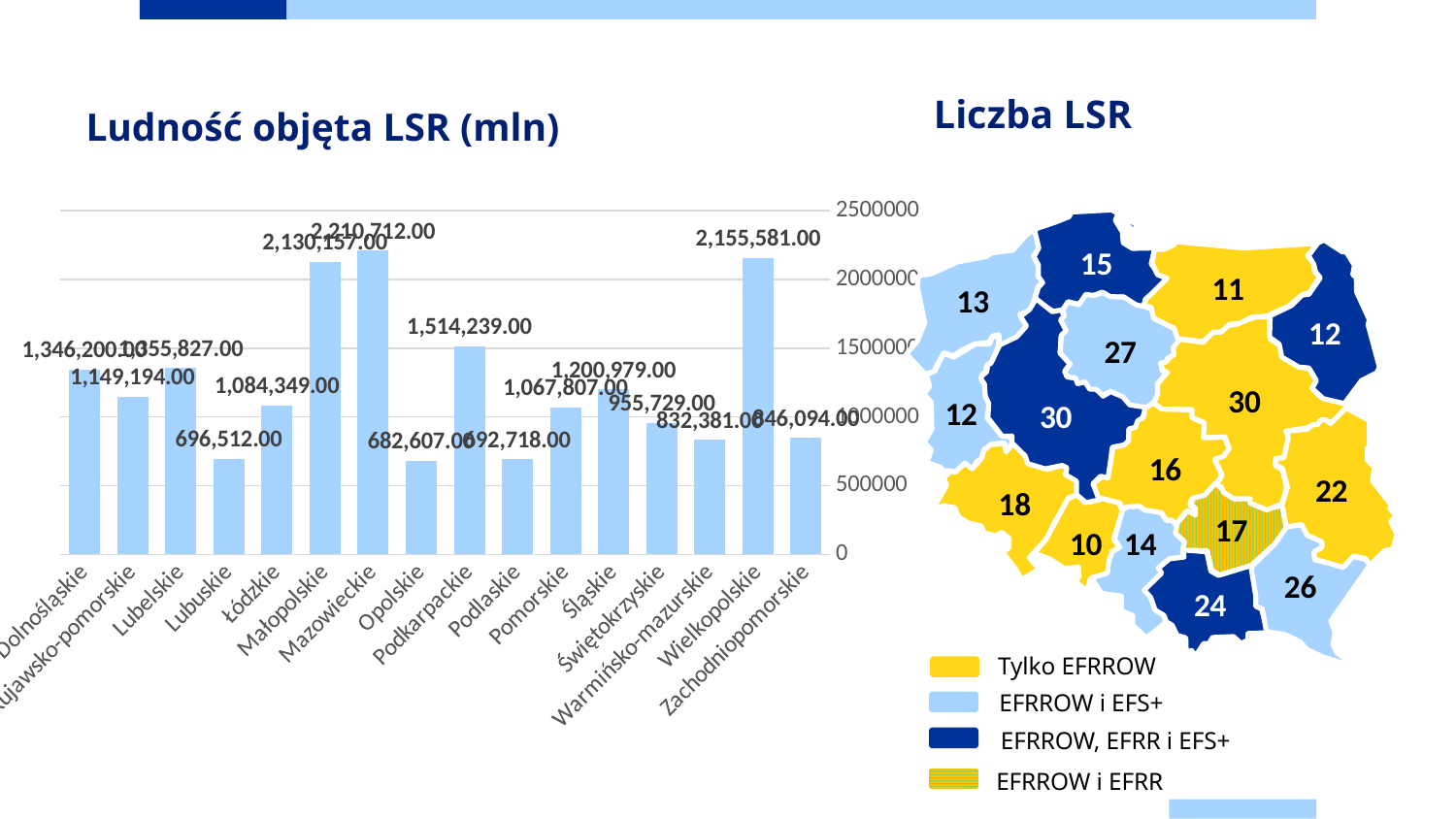
In the chart 'Ludność objęta LSR (mln)', is the value for Śląskie greater or less than 1000000? greater In the chart 'Ludność objęta LSR (mln)', which voivodeship has the highest value? Mazowieckie In the chart 'Ludność objęta LSR (mln)', which is larger, the value for Wielkopolskie or the value for Małopolskie? Wielkopolskie How many voivodeships are shown on the x axis of the chart 'Ludność objęta LSR (mln)'? 16 In the chart 'Ludność objęta LSR (mln)', what is the difference between the values for Mazowieckie and Małopolskie? 80,555.00 In the chart 'Ludność objęta LSR (mln)', which voivodeship has the lowest value? Opolskie In the chart 'Ludność objęta LSR (mln)', what is the value for Świętokrzyskie? 955,729.00 In the chart 'Ludność objęta LSR (mln)', what is the value for Podkarpackie? 1,514,239.00 In the chart 'Ludność objęta LSR (mln)', what is the difference between the values for Podkarpackie and Pomorskie? 446,432.00 What kind of chart is 'Ludność objęta LSR (mln)'? bar chart In the chart 'Ludność objęta LSR (mln)', what is the value for Mazowieckie? 2,210,712.00 In the chart 'Ludność objęta LSR (mln)', what is the value for Lubuskie? 696,512.00